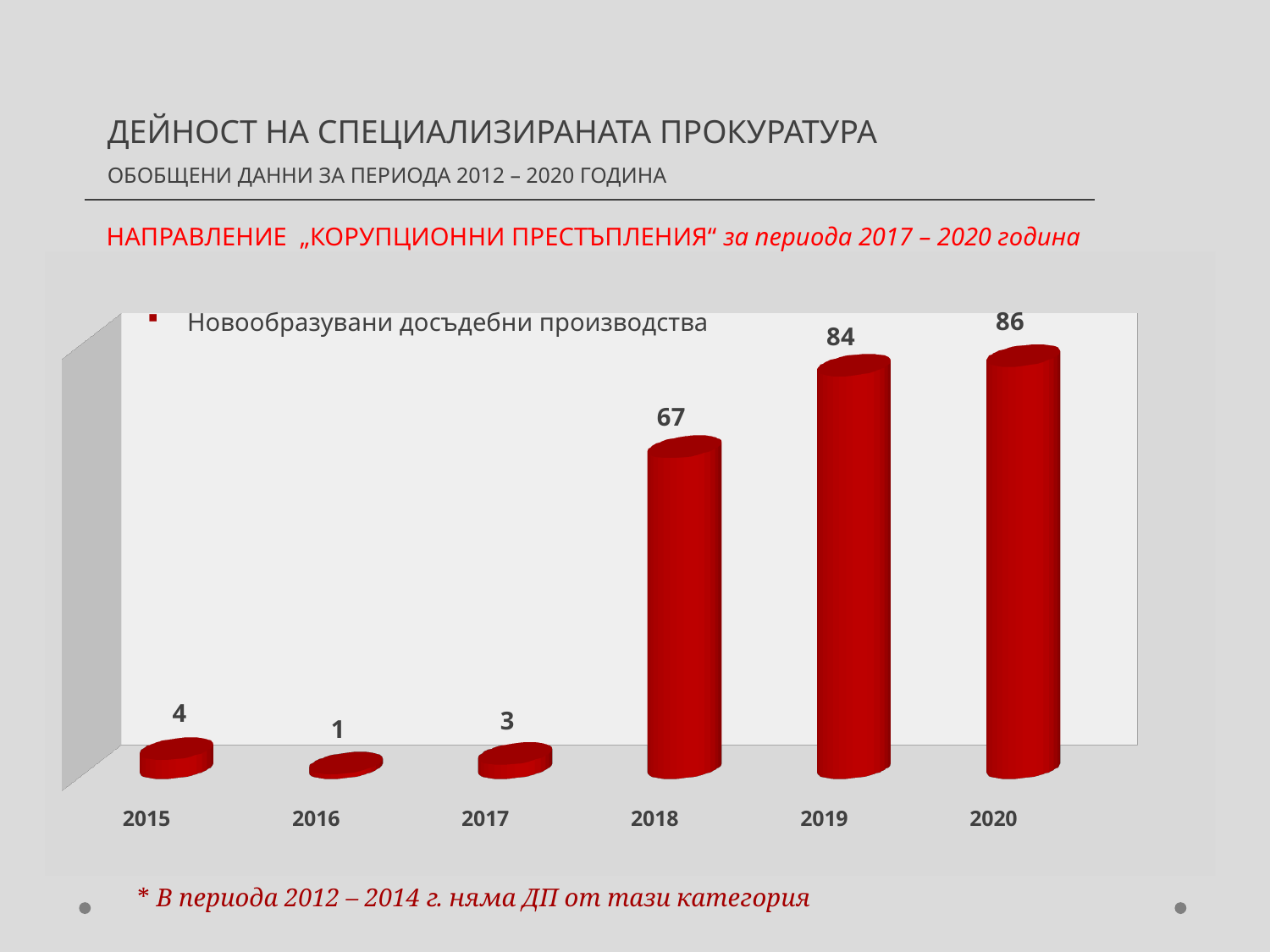
How many years are shown on the x axis? 6 What is the difference between the values for 2020 and 2015? 82 What is the value for 2018? 67 What series name does the legend show? Новообразувани досъдебни производства What kind of chart is shown on the slide? bar chart Which is larger, the value for 2017 or the value for 2015? 2015 Which year has the highest value? 2020 Do the values generally rise or fall from 2017 to 2020? rise What is the difference between the values for 2019 and 2018? 17 Which year has the lowest value? 2016 What is the value for 2015? 4 What is the value for 2020? 86